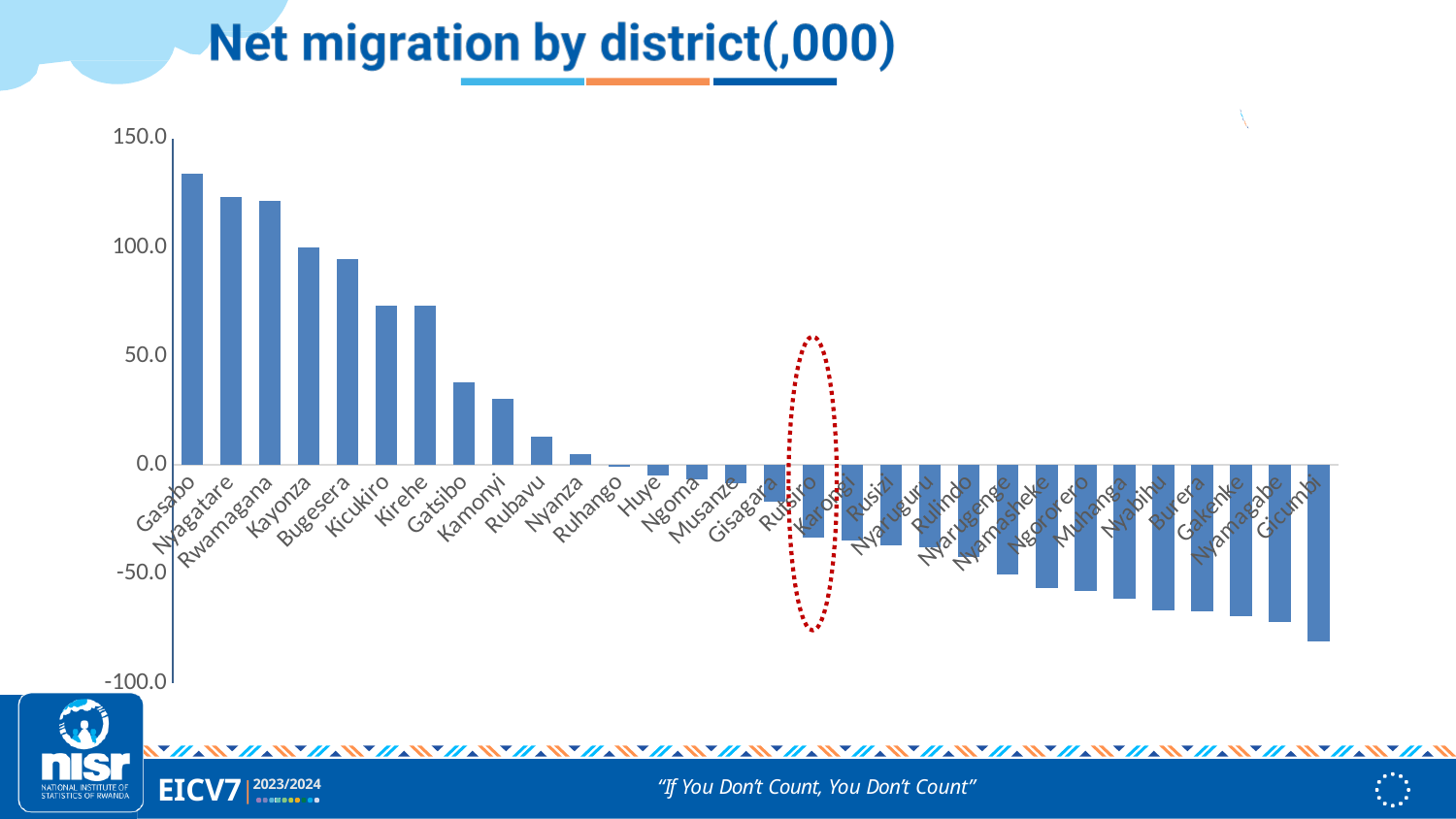
Is the value for Bugesera greater or less than 100.0? less Which district has the highest net migration? Gasabo Is the value for Gicumbi greater or less than -50.0? less What type of chart is shown on the slide? Bar chart Do the values rise or fall moving from left to right along the x axis? Fall Is the value for Gatsibo greater or less than 50.0? less What is the title of the chart? Net migration by district(,000) Which has the larger net migration, Gasabo or Nyagatare? Gasabo How many districts are shown on the chart? 30 Which district has the lowest net migration? Gicumbi